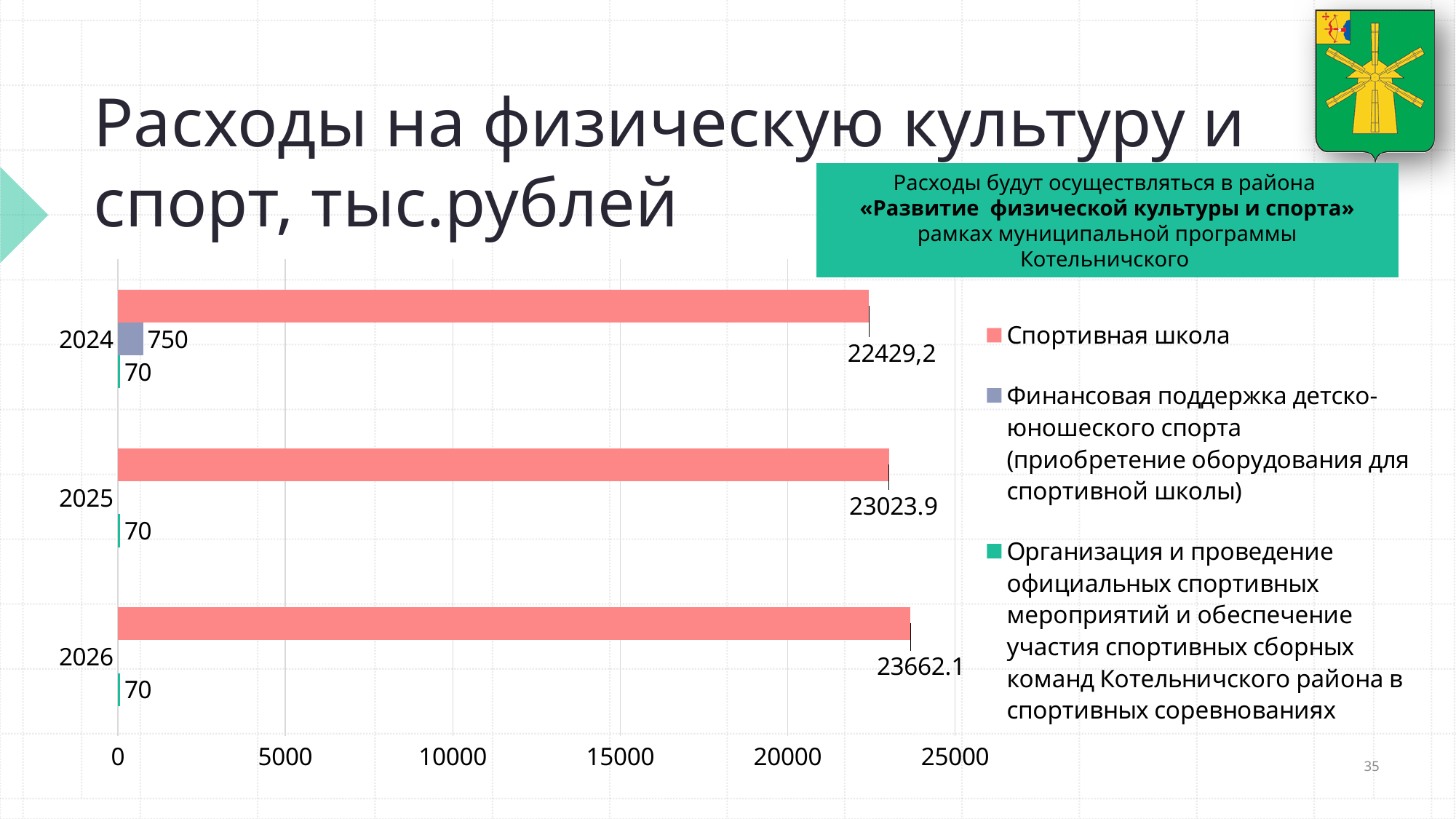
Which is larger: the value for Спортивная школа in 2025 or in 2026? 2026 Does the value for Спортивная школа rise or fall from 2024 to 2026? rise What type of chart is shown on the slide? bar chart What is the value for Спортивная школа in 2024? 22429,2 In which year is the value for Спортивная школа the highest? 2026 In which year is the value for Спортивная школа the lowest? 2024 What is the value for Организация и проведение официальных спортивных мероприятий in 2026? 70 What is the value for Спортивная школа in 2025? 23023.9 What is the value for Финансовая поддержка детско-юношеского спорта in 2024? 750 What is the value for Спортивная школа in 2026? 23662.1 Is the value for Спортивная школа in 2024 greater or less than 20000? greater How many series does the legend list? 3